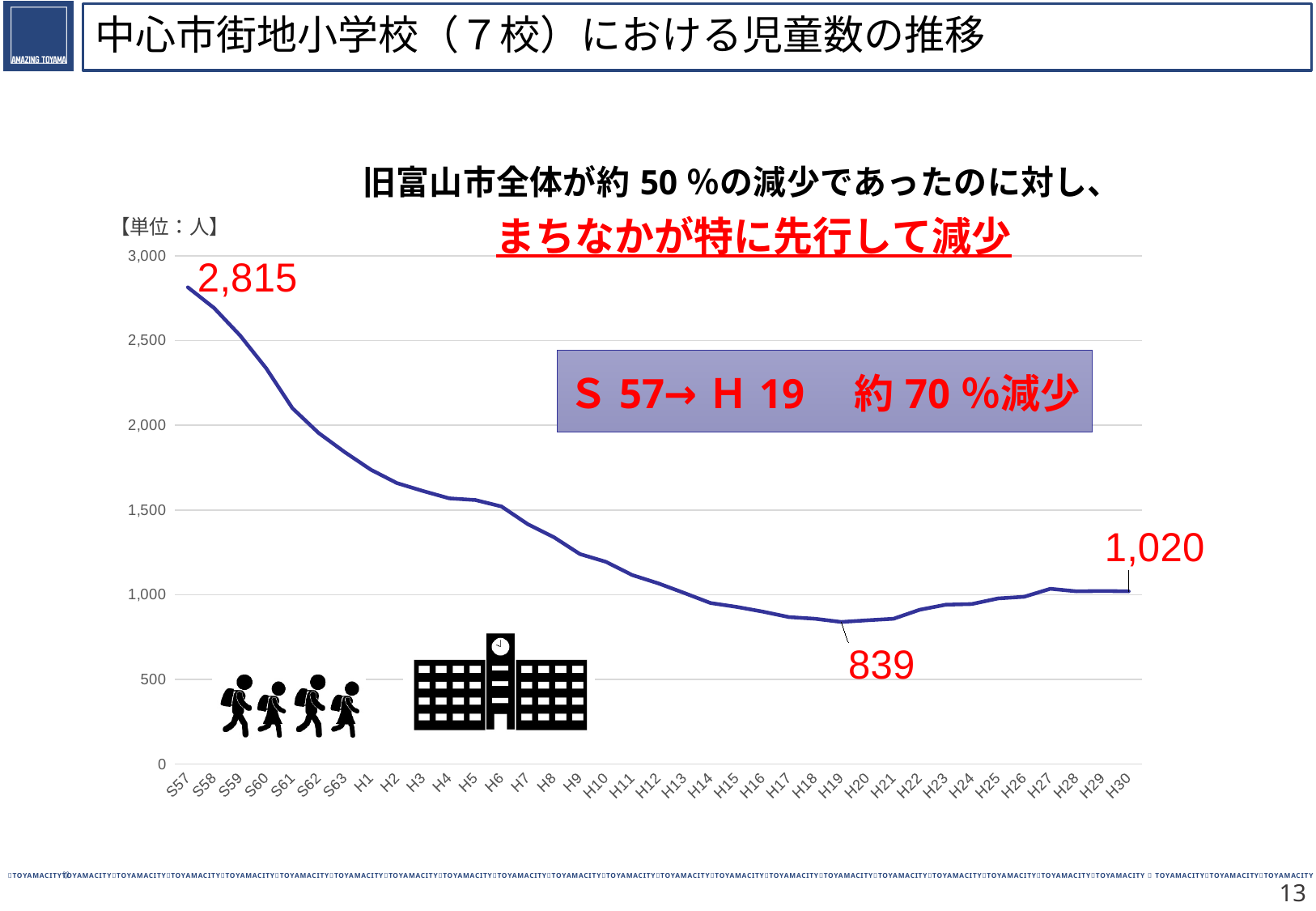
Which is larger, the value for S57 or the value for H30? S57 What is the number of students shown for S57? 2,815 What is the difference between the number of students in H30 and in H19? 181 Which year has the highest number of students on the chart? S57 What kind of chart is shown on the slide? line chart What is the difference between the number of students in S57 and in H19? 1,976 What is the number of students shown for H19? 839 What is the number of students shown for H30? 1,020 Is the value for H1 greater or less than 1,500? greater What is the unit of the values shown on the chart? 人 Is the value for H10 greater or less than 1,500? less Which year has the lowest number of students on the chart? H19